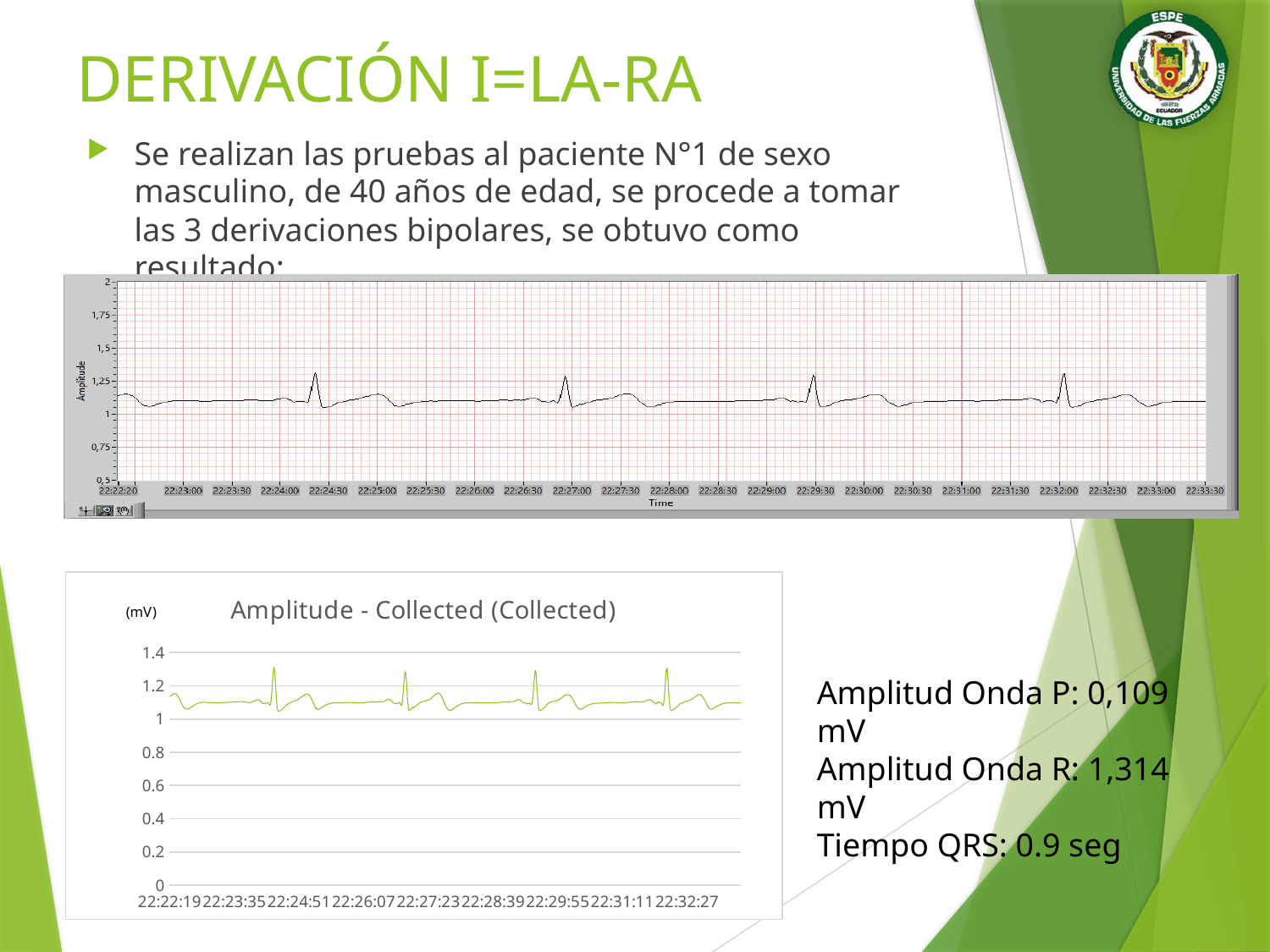
What is the title of the bottom chart? Amplitude - Collected (Collected) In the bottom chart, is the height of the sharp peaks greater or less than 1.4? less What kind of chart is the bottom chart titled "Amplitude - Collected (Collected)"? line chart In the top chart, how many sharp peaks are visible in the signal? 4 In the bottom chart, what unit is shown for the vertical axis? mV In the bottom chart, how many sharp peaks (R waves) are visible in the line? 4 In the bottom chart, does the baseline of the signal rise, fall, or stay roughly flat across the time axis? roughly flat In the top chart, is the height of the sharp peaks greater or less than 1.5? less In the bottom chart, is the height of the sharp peaks greater or less than 1.2? greater